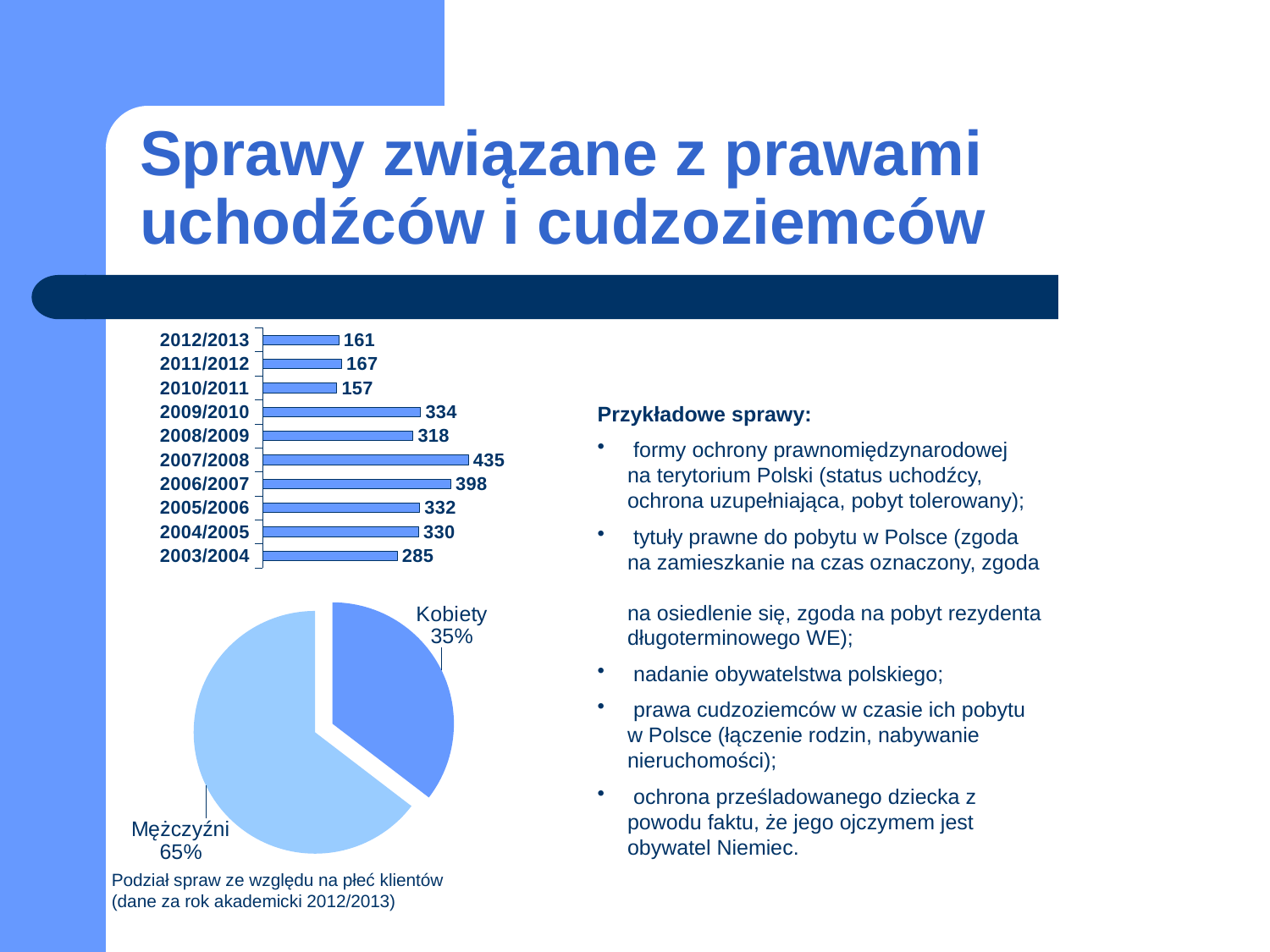
In the pie chart at the bottom left, what share of cases is for Mężczyźni? 65% In the pie chart at the bottom left, what share of cases is for Kobiety? 35% In the bar chart at the top left, which is larger, the value for 2009/2010 or the value for 2008/2009? 2009/2010 In the bar chart at the top left, which academic year has the lowest value? 2010/2011 In the bar chart at the top left, which academic year has the highest value? 2007/2008 What kind of chart is the chart at the bottom left of the slide? Pie chart In the bar chart at the top left, how many academic years are shown? 10 In the pie chart at the bottom left, which slice is larger, Kobiety or Mężczyźni? Mężczyźni What kind of chart is the chart at the top left of the slide? Bar chart In the bar chart at the top left, what is the value for 2007/2008? 435 In the bar chart at the top left, what is the value for 2003/2004? 285 In the bar chart at the top left, what is the difference between the values for 2007/2008 and 2006/2007? 37